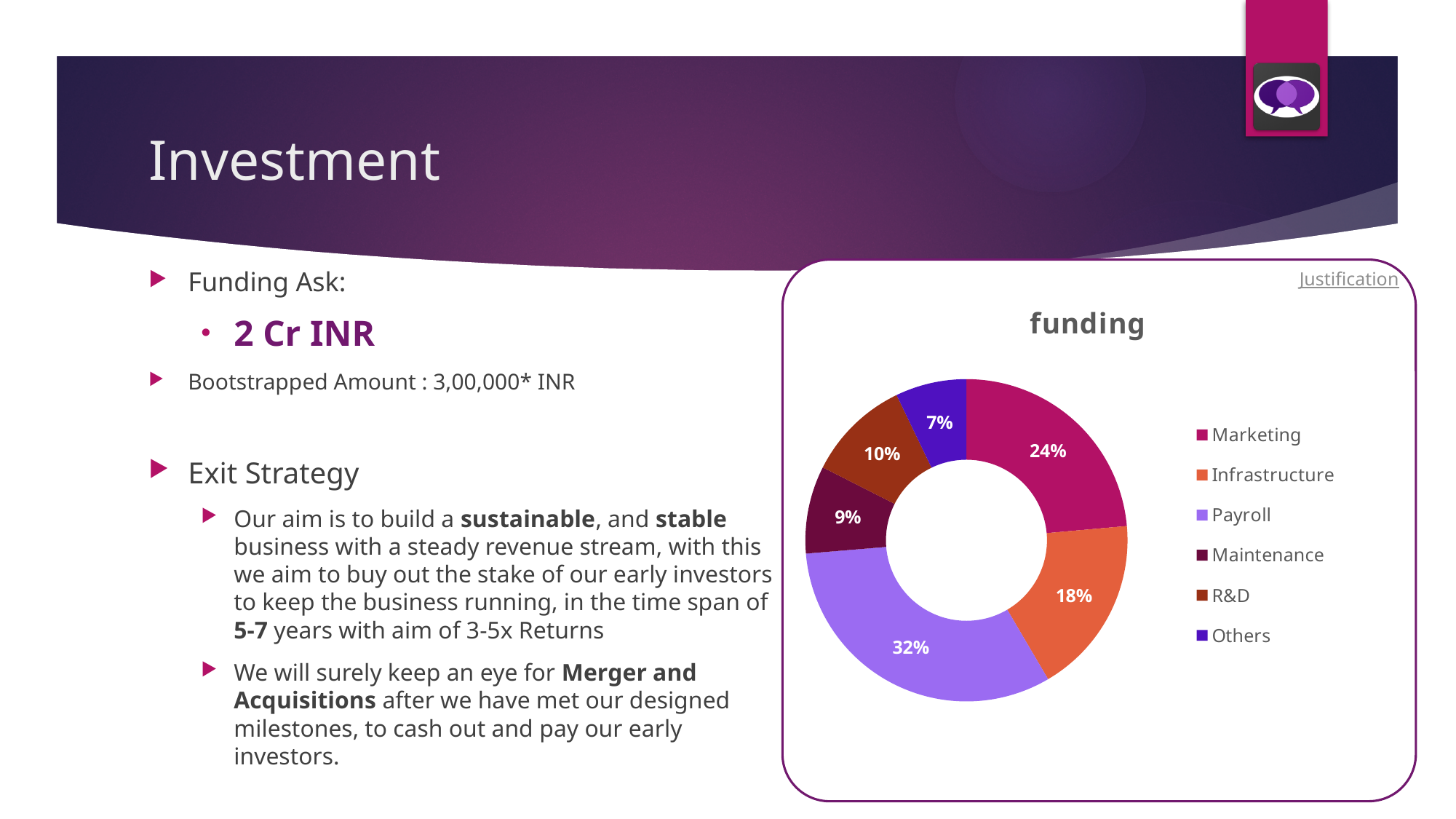
What share of funding goes to Marketing? 24% What share of funding goes to Infrastructure? 18% How many percentage points larger is the Payroll share than the Marketing share? 8 Which has a larger share of funding, Maintenance or R&D? R&D Which category receives the smallest share of funding? Others What share of funding goes to R&D? 10% What kind of chart is used to show the funding breakdown? Doughnut (pie) chart What share of funding goes to Payroll? 32% What is the combined share of Marketing and Infrastructure? 42% What is the title of the chart? funding Which category receives the largest share of funding? Payroll How many categories are shown in the funding chart? 6